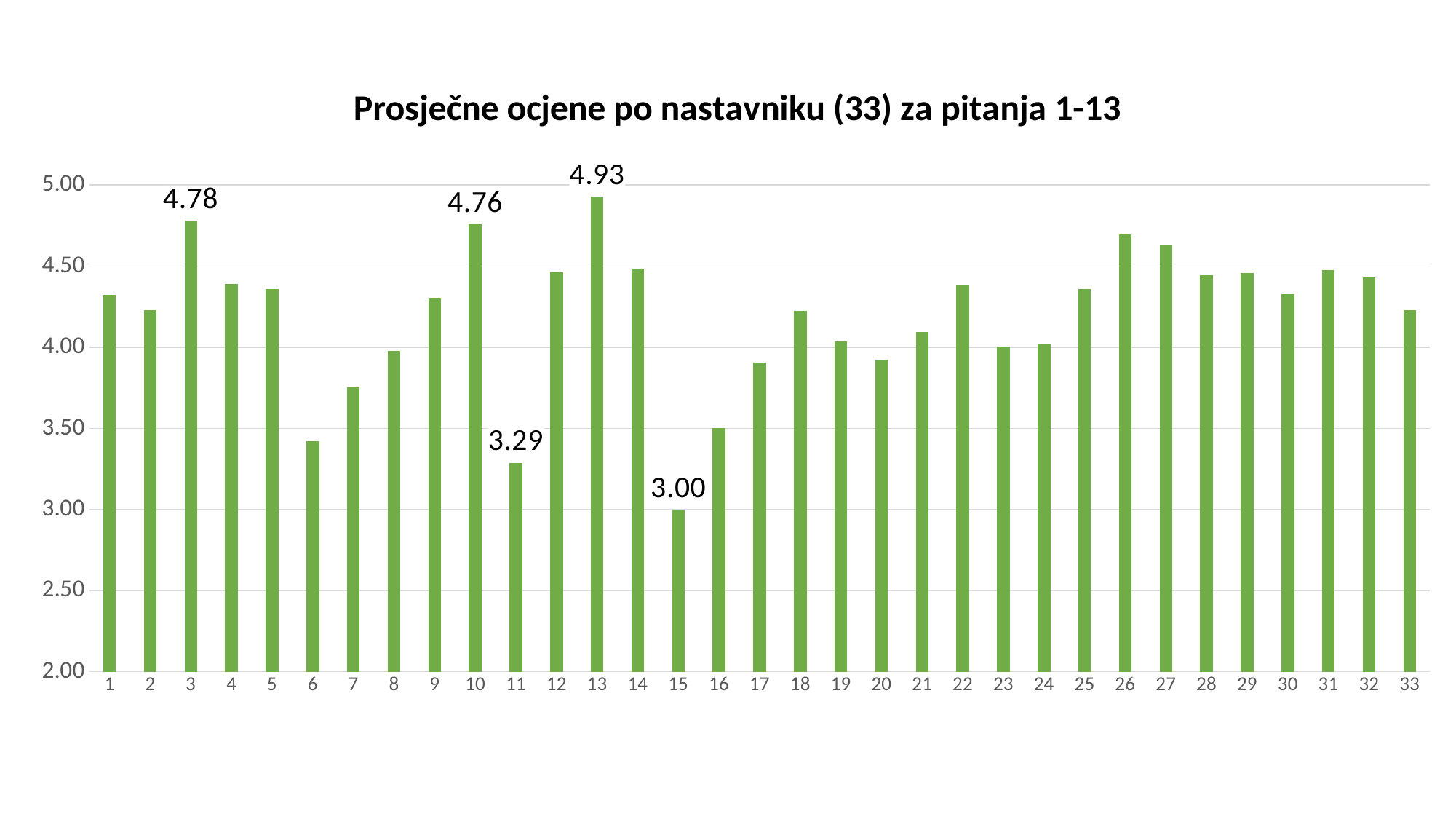
Which is larger, the value for teacher 6 or the value for teacher 7? teacher 7 What is the difference between the values for teacher 13 and teacher 15? 1.93 What type of chart is shown on the slide? bar chart What is the value for teacher 13? 4.93 What is the value for teacher 3? 4.78 What is the value for teacher 15? 3.00 How many teachers (bars) are shown in the chart? 33 Is the value for teacher 26 greater or less than 4.50? greater Which teacher has the highest average rating? 13 Which teacher has the lowest average rating? 15 What is the value for teacher 11? 3.29 What is the difference between the values for teacher 3 and teacher 10? 0.02